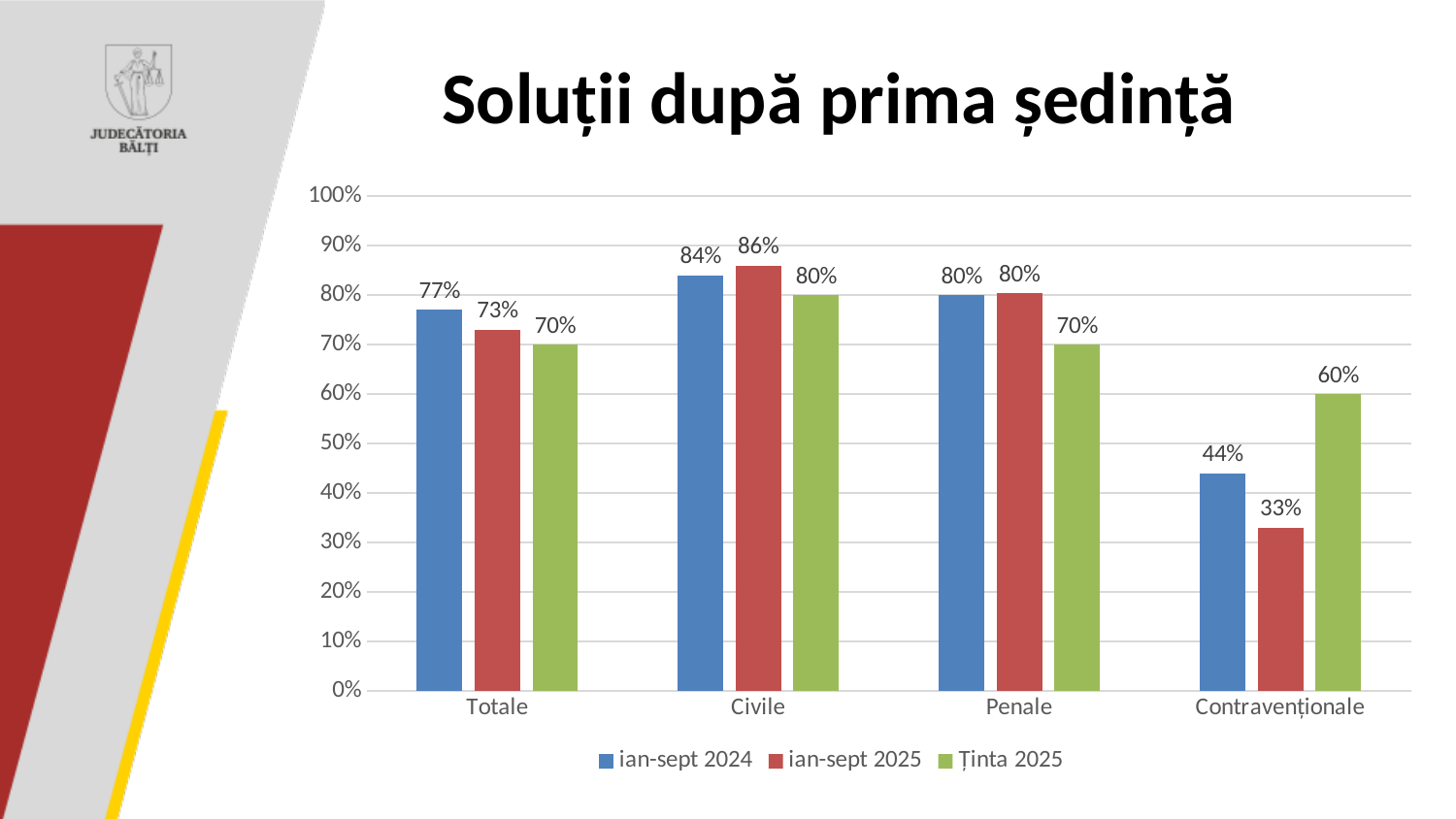
Which category has the lowest ian-sept 2025 value? Contravenționale Is the ian-sept 2025 value for Contravenționale greater or less than 40%? less Which category has the highest ian-sept 2024 value? Civile What is the value for Civile in the ian-sept 2025 series? 86% Which is larger for Totale: the ian-sept 2024 value or the ian-sept 2025 value? ian-sept 2024 What is the Ținta 2025 value for Contravenționale? 60% What is the difference between the ian-sept 2024 and ian-sept 2025 values for Contravenționale? 11% How many series does the legend list? 3 What is the title of the chart? Soluții după prima ședință How many categories are shown on the x axis? 4 What is the ian-sept 2024 value for Totale? 77% What kind of chart is shown on the slide? bar chart